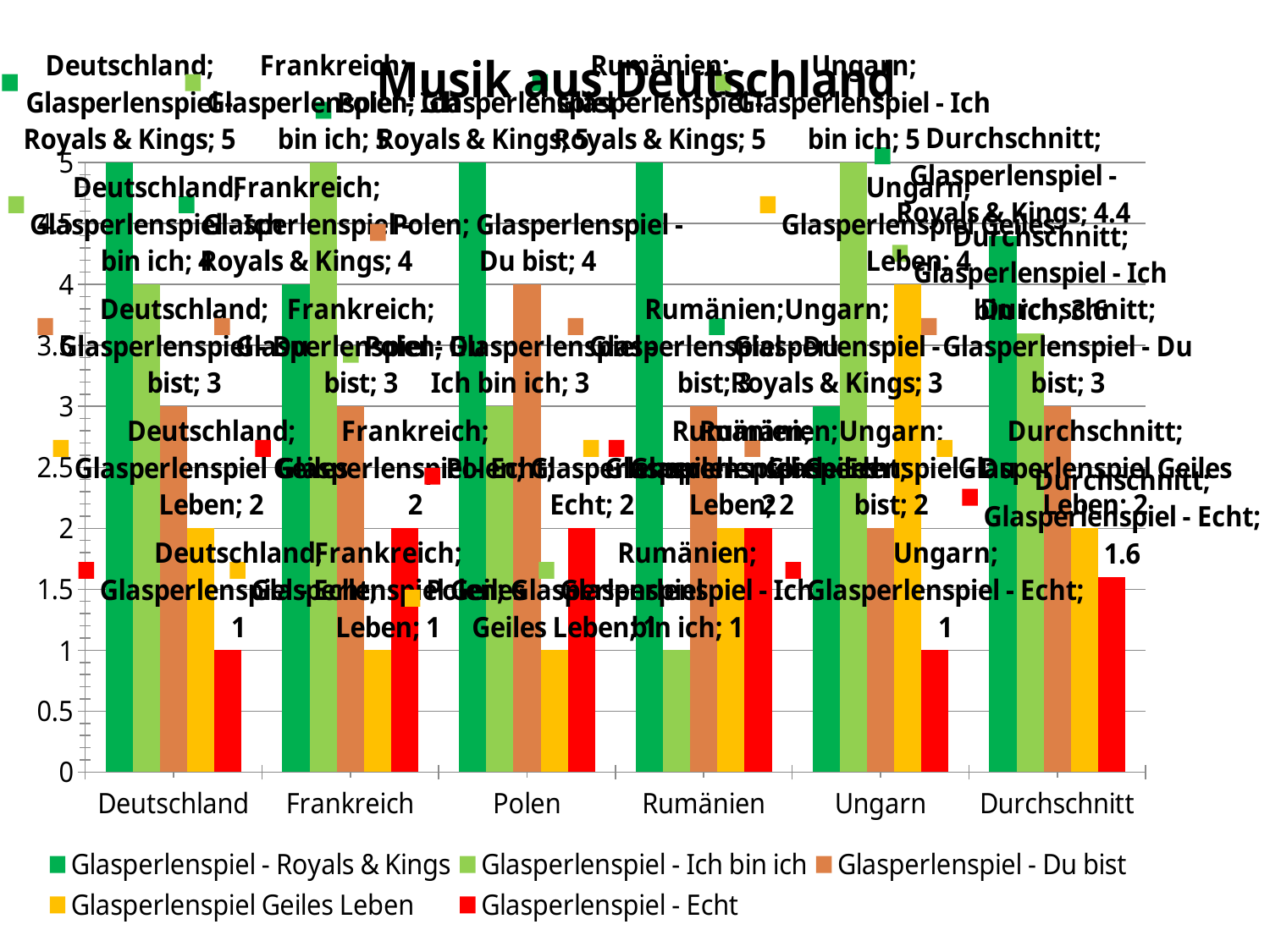
What is the value for Glasperlenspiel Geiles Leben in the Ungarn category? 4 Which is larger in the Polen category: Glasperlenspiel - Du bist or Glasperlenspiel - Ich bin ich? Glasperlenspiel - Du bist How many categories are shown on the x axis? 6 What is the difference between Glasperlenspiel - Royals & Kings and Glasperlenspiel - Ich bin ich in the Durchschnitt category? 0.8 What type of chart is shown on the slide? bar chart What is the title of the chart? Musik aus Deutschland Which series has the highest value in the Frankreich category? Glasperlenspiel - Ich bin ich Which colour represents Glasperlenspiel - Echt in the chart? red How many series does the legend list? 5 Which series has the lowest value in the Rumänien category? Glasperlenspiel - Ich bin ich What is the value for Glasperlenspiel - Royals & Kings in the Durchschnitt category? 4.4 What is the value for Glasperlenspiel - Echt in the Durchschnitt category? 1.6